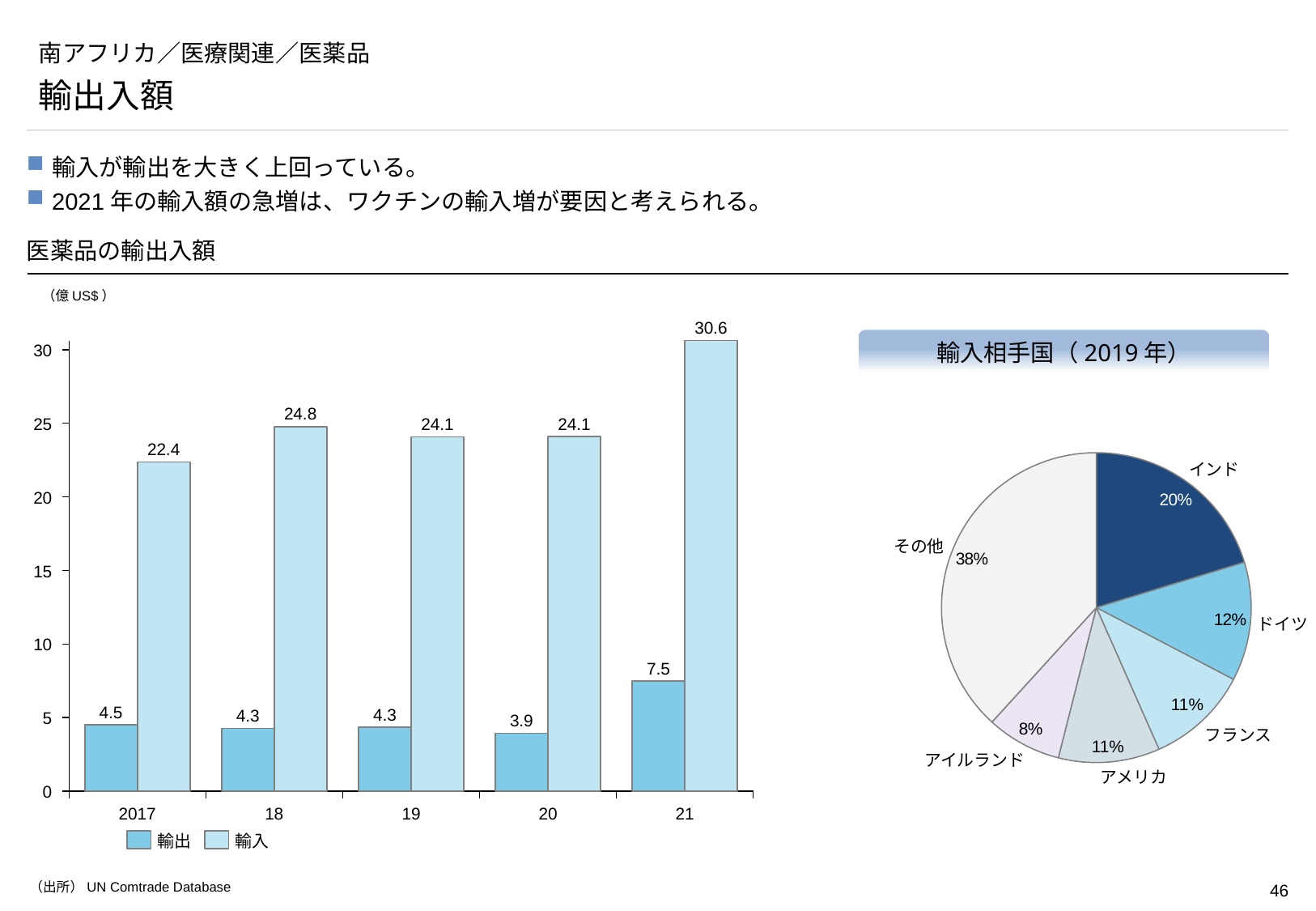
In the pie chart 輸入相手国（2019年）, which named country has the smallest share? アイルランド In the pie chart 輸入相手国（2019年）, how many slices are there? 6 In the bar chart 医薬品の輸出入額, how many series does the legend list? 2 In the bar chart 医薬品の輸出入額, is the 輸入 value for 2018 larger than the 輸入 value for 2017? Yes In the bar chart 医薬品の輸出入額, what is the 輸入 value for 2021? 30.6 In the bar chart 医薬品の輸出入額, which year has the lowest 輸出 value? 2020 In the pie chart 輸入相手国（2019年）, what share does インド have? 20% In the bar chart 医薬品の輸出入額, what is the difference between 輸入 and 輸出 in 2021? 23.1 What type of chart is 医薬品の輸出入額? Bar chart In the bar chart 医薬品の輸出入額, which year has the highest 輸入 value? 2021 In the bar chart 医薬品の輸出入額, what is the 輸出 value for 2017? 4.5 In the bar chart 医薬品の輸出入額, how many years are shown on the x axis? 5